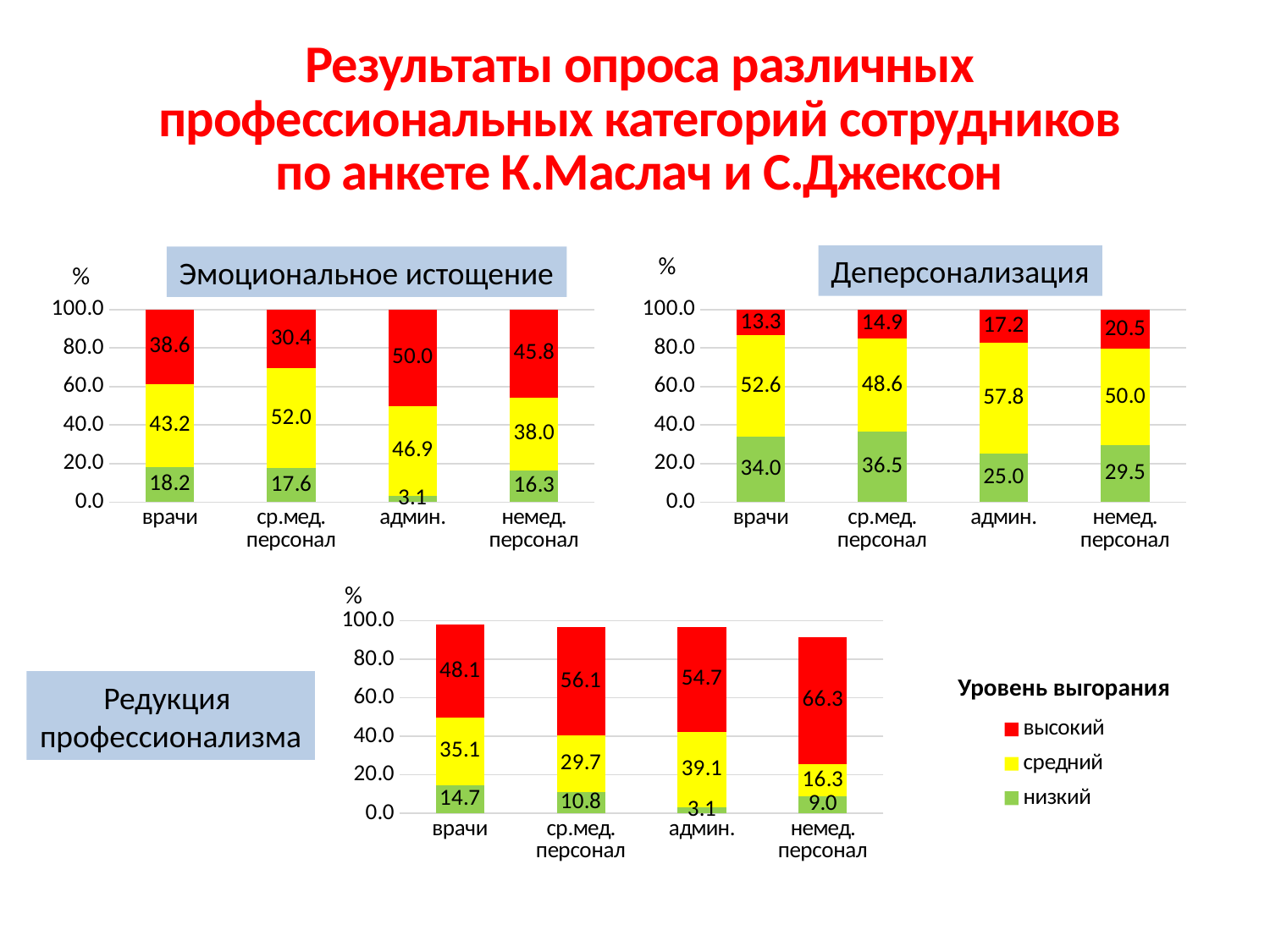
In the 'Эмоциональное истощение' chart, what is the value of 'высокий' for 'админ.'? 50.0 In the 'Деперсонализация' chart, which category has the lowest 'низкий' value? админ. What type of chart is the 'Деперсонализация' chart? stacked bar chart In the 'Деперсонализация' chart, what is the value of 'низкий' for 'ср.мед. персонал'? 36.5 In the 'Деперсонализация' chart, what is the total of the stacked bar for 'врачи'? 99.9 In the 'Эмоциональное истощение' chart, what is the difference between the 'средний' values for 'ср.мед. персонал' and 'врачи'? 8.8 In the 'Редукция профессионализма' chart, what is the value of 'средний' for 'немед. персонал'? 16.3 In the 'Деперсонализация' chart, which is larger: the 'высокий' value for 'врачи' or for 'немед. персонал'? немед. персонал How many categories are shown on the x axis of the 'Редукция профессионализма' chart? 4 In the 'Редукция профессионализма' chart, which category has the highest 'высокий' value? немед. персонал How many series does the 'Уровень выгорания' legend list? 3 Which colour represents 'низкий' in the legend? green